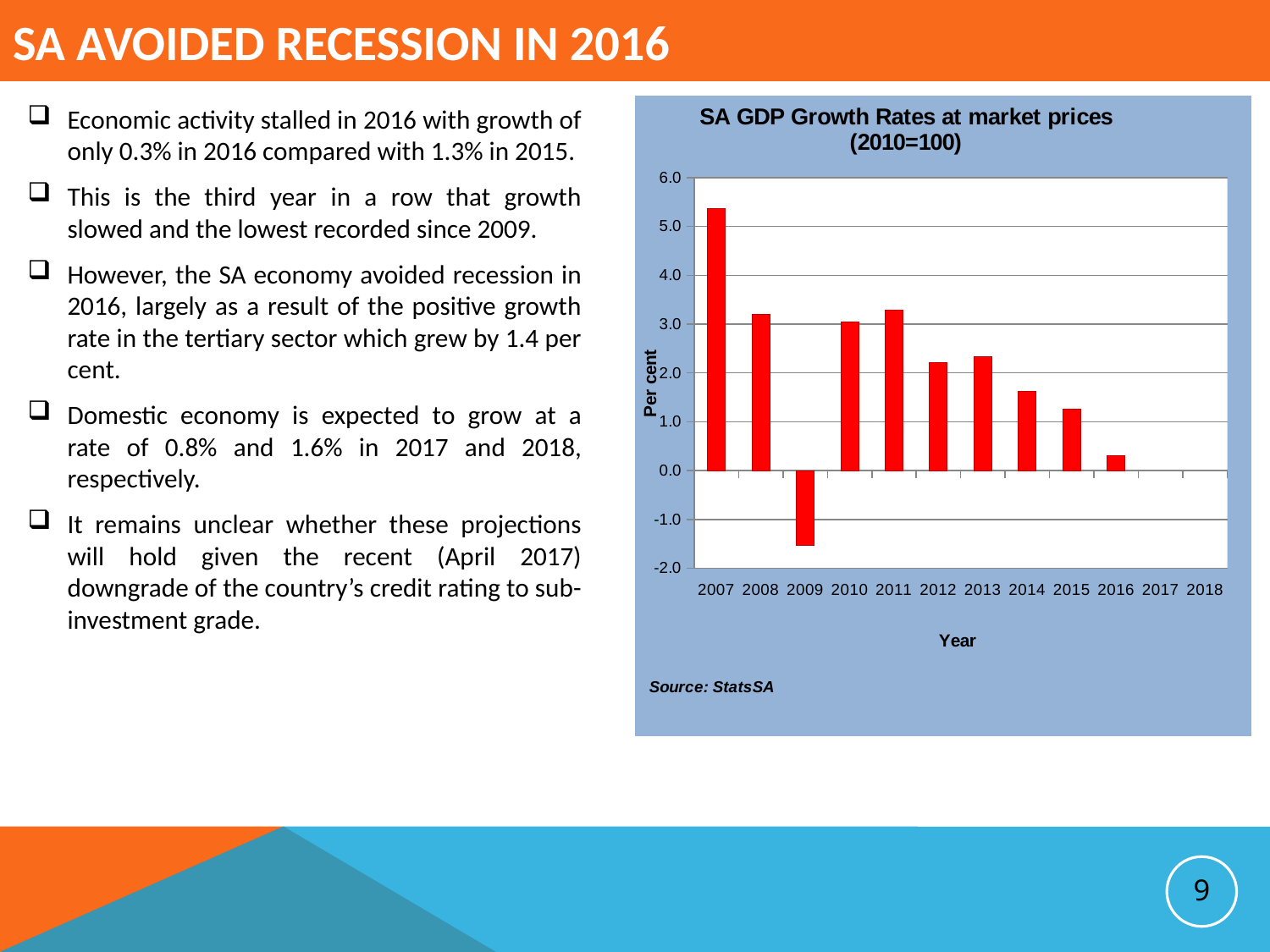
Do the GDP growth rates rise or fall from 2011 to 2016? fall Which year has the larger GDP growth rate, 2008 or 2016? 2008 Is the value for 2014 greater or less than 1.0? greater Which year has the lowest GDP growth rate in the chart? 2009 How many years are labelled on the x axis of the chart? 12 Is the value for 2009 greater or less than 0.0? less Is the value for 2007 greater or less than 5.0? greater What kind of chart is shown on the slide? bar chart Which year has the highest GDP growth rate in the chart? 2007 What is the label on the y axis of the chart? Per cent What is the title of the chart? SA GDP Growth Rates at market prices (2010=100)